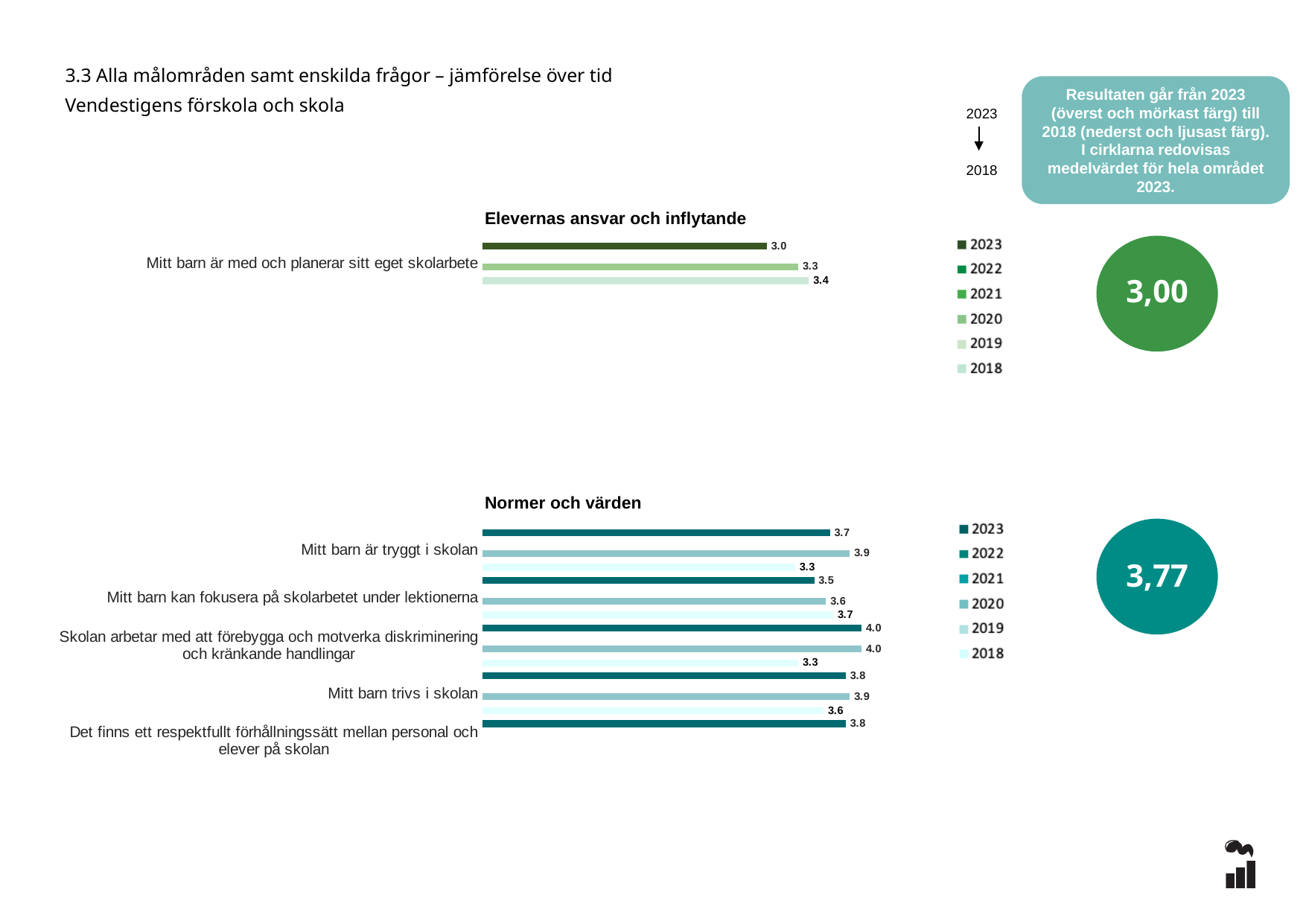
In the "Normer och värden" chart, which has the larger 2023 value: "Mitt barn är tryggt i skolan" or "Mitt barn trivs i skolan"? Mitt barn trivs i skolan In the "Elevernas ansvar och inflytande" chart, what is the value of the lowest (lightest) bar for "Mitt barn är med och planerar sitt eget skolarbete"? 3.4 In the "Normer och värden" chart, what is the 2023 value (top, darkest bar) for "Skolan arbetar med att förebygga och motverka diskriminering och kränkande handlingar"? 4.0 In the "Normer och värden" chart, which category has the lowest 2023 value (top, darkest bar)? Mitt barn kan fokusera på skolarbetet under lektionerna What kind of chart is "Elevernas ansvar och inflytande"? bar chart In the "Normer och värden" chart, what is the 2023 value (top, darkest bar) for "Mitt barn är tryggt i skolan"? 3.7 In the "Elevernas ansvar och inflytande" chart, what is the 2023 value (top, darkest bar) for "Mitt barn är med och planerar sitt eget skolarbete"? 3.0 In the "Normer och värden" chart, which category has the highest 2023 value (top, darkest bar)? Skolan arbetar med att förebygga och motverka diskriminering och kränkande handlingar How many series does the legend of the "Elevernas ansvar och inflytande" chart list? 6 What mean value for 2023 is shown in the circle next to the "Normer och värden" chart? 3,77 In the "Normer och värden" chart, what is the difference between the 2023 values for "Skolan arbetar med att förebygga och motverka diskriminering och kränkande handlingar" and "Mitt barn kan fokusera på skolarbetet under lektionerna"? 0.5 How many categories are shown in the "Normer och värden" chart? 5